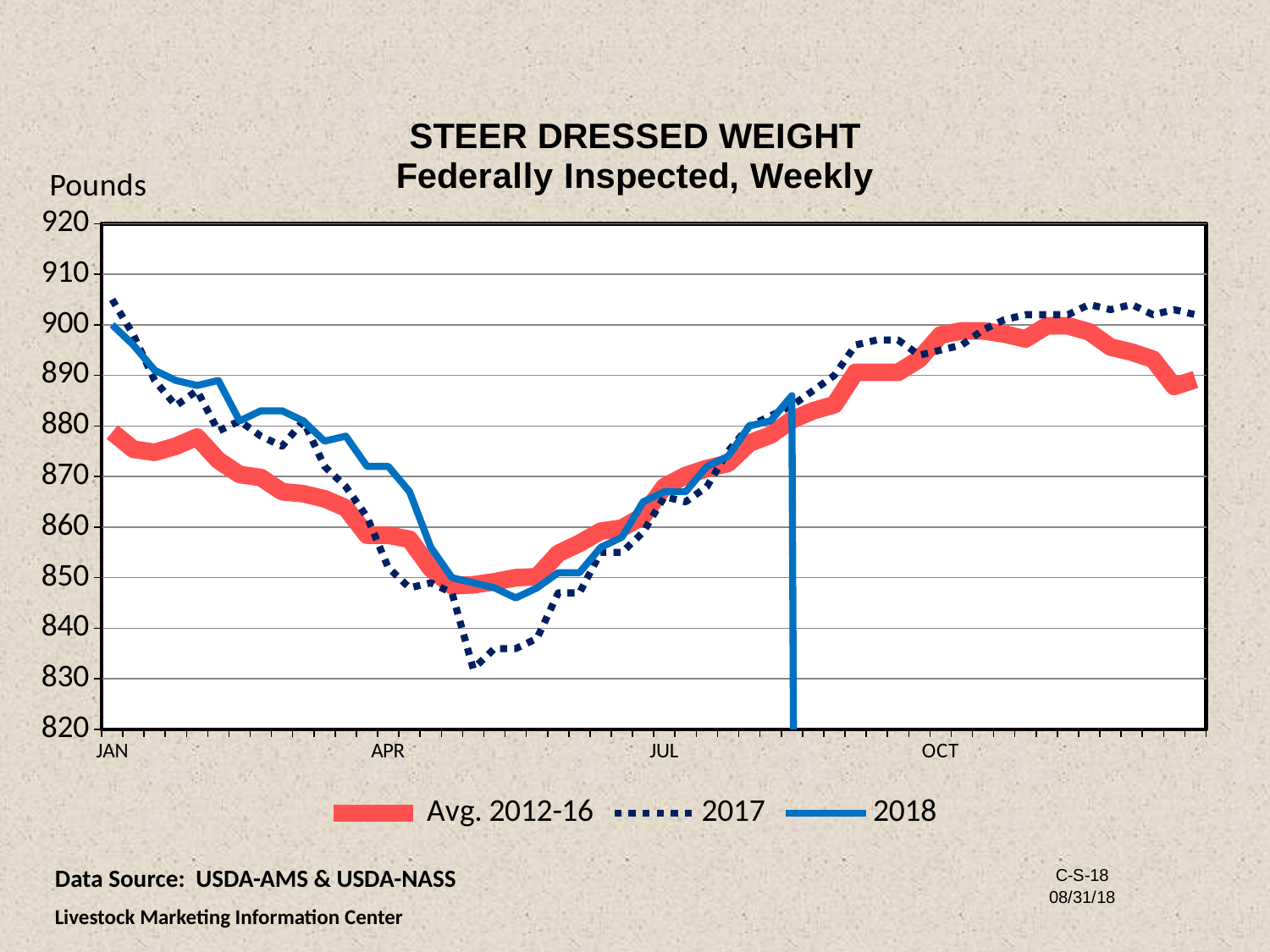
Is the lowest value of the 2017 series greater or less than 840? less Is the lowest value of the 2018 series greater or less than 850? less Does the Avg. 2012-16 series rise or fall from JAN to APR? fall What unit is shown on the vertical axis label? Pounds How many series does the legend list? 3 Is the value for 2017 at the start of January greater or less than 900? greater Which series reaches the lowest value on the chart? 2017 At the end of the year (right edge of the chart), which is higher: 2017 or Avg. 2012-16? 2017 At the start of January, which is higher: 2017 or Avg. 2012-16? 2017 What is the title of the chart? STEER DRESSED WEIGHT Federally Inspected, Weekly What kind of chart is shown on the slide? line chart